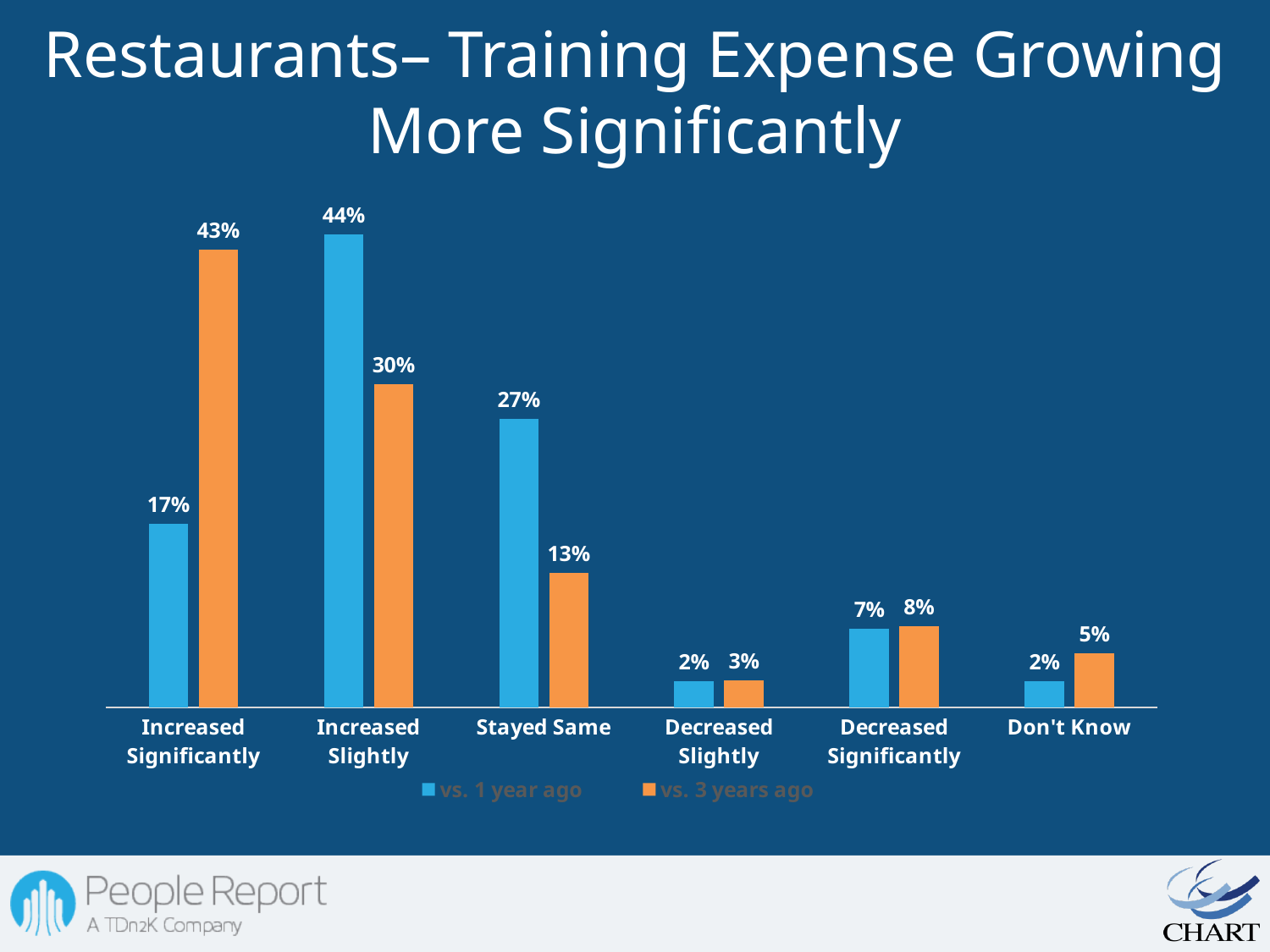
Which series is shown in orange? vs. 3 years ago What is the value for Stayed Same in the vs. 1 year ago series? 27% What is the value for Increased Significantly in the vs. 3 years ago series? 43% How many categories are shown on the x axis? 6 Which category has the highest value in the vs. 1 year ago series? Increased Slightly Which is larger for Increased Slightly: vs. 1 year ago or vs. 3 years ago? vs. 1 year ago What is the value for Don't Know in the vs. 3 years ago series? 5% What is the difference between the vs. 1 year ago and vs. 3 years ago values for Stayed Same? 14% Which category has the lowest value in the vs. 3 years ago series? Decreased Slightly How many series does the legend list? 2 What kind of chart is shown on the slide? Bar chart What is the difference between the vs. 1 year ago and vs. 3 years ago values for Increased Significantly? 26%